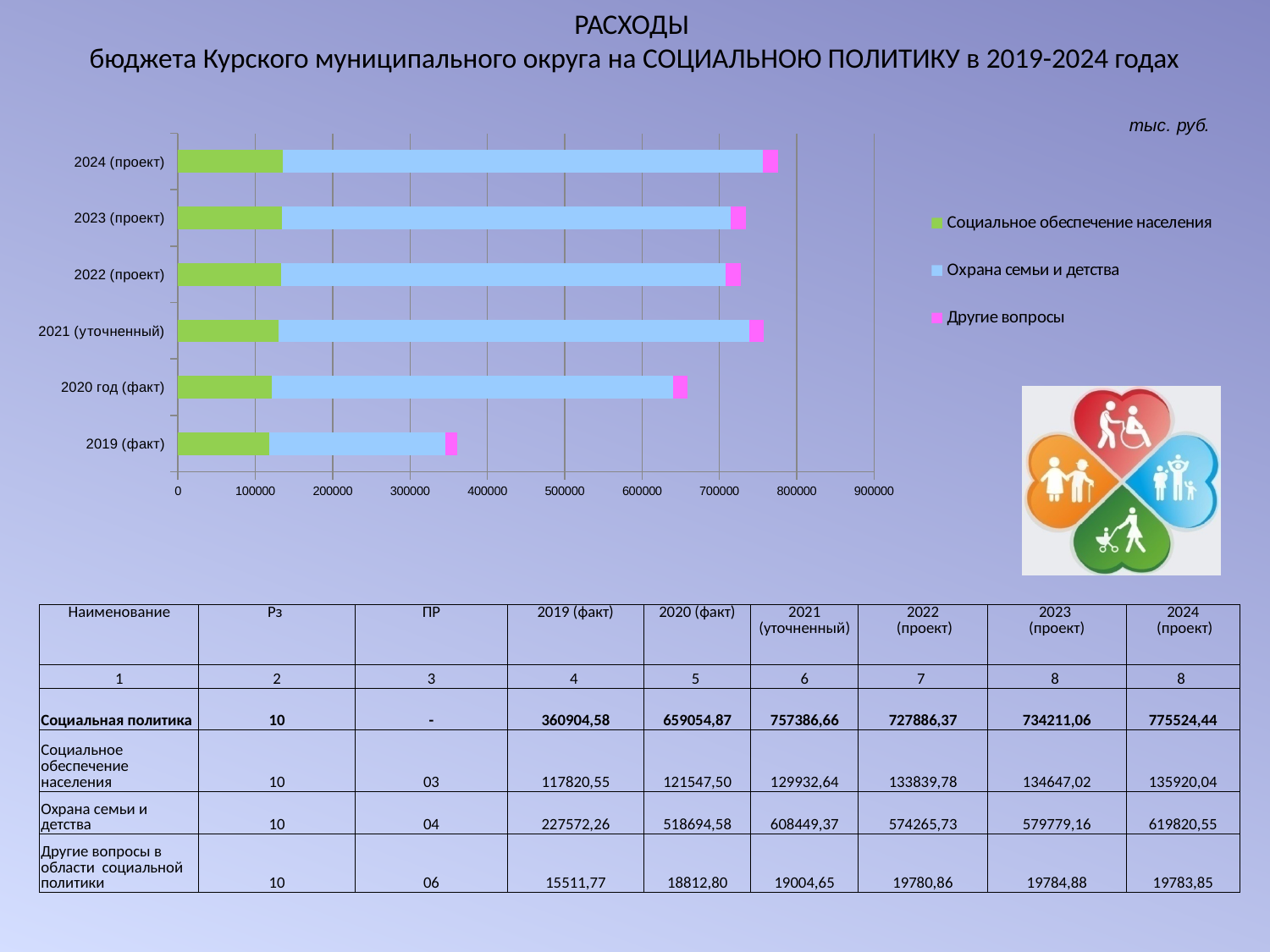
Which is larger for Охрана семьи и детства: 2020 (факт) or 2021 (уточненный)? 2021 (уточненный) Is the total bar for 2019 (факт) greater or less than 400000? less What is the total of the stacked bar for 2024 (проект)? 775524,44 What is the value of Охрана семьи и детства for 2021 (уточненный)? 608449,37 How many year categories are plotted on the chart? 6 Which year has the shortest total bar on the chart? 2019 (факт) Is the total bar for 2020 год (факт) greater or less than 600000? greater How many series does the chart legend list? 3 What kind of chart is shown on the slide? Stacked horizontal bar chart What is the difference between Социальное обеспечение населения in 2024 (проект) and in 2019 (факт)? 18099,49 What colour represents Другие вопросы in the chart legend? Pink (magenta) Which year has the longest total bar on the chart? 2024 (проект)